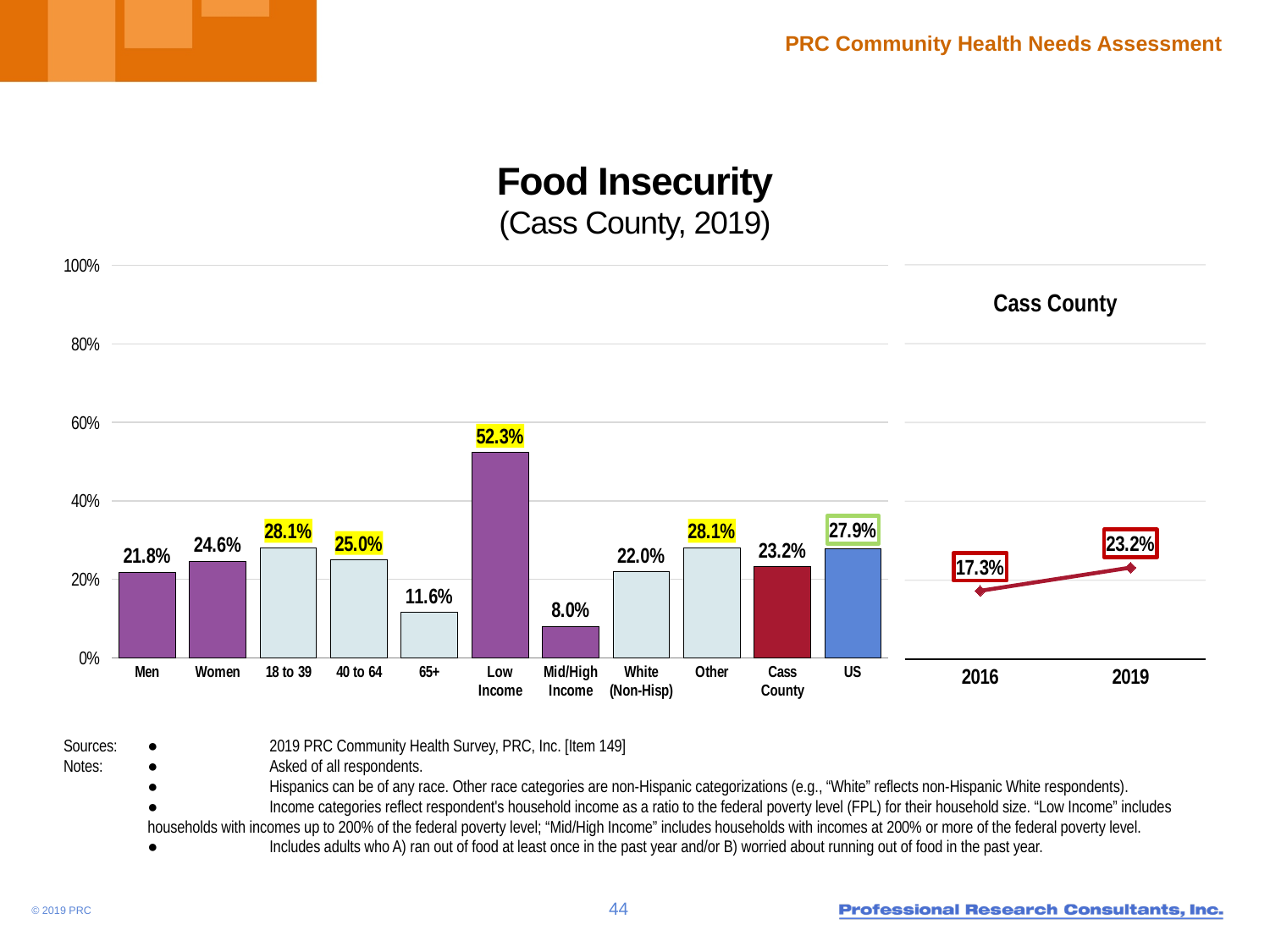
In the Food Insecurity bar chart, what is the value for Women? 24.6% In the Cass County trend chart on the right, what is the difference between the 2019 and 2016 values? 5.9% What kind of chart is the Food Insecurity chart on the left? bar chart In the Food Insecurity bar chart, what is the difference between the Low Income and Mid/High Income values? 44.3% In the Food Insecurity bar chart, which category has the highest value? Low Income How many categories are shown in the Food Insecurity bar chart? 11 In the Cass County trend chart on the right, does the value rise or fall from 2016 to 2019? rise In the Food Insecurity bar chart, what is the value for Low Income? 52.3% In the Cass County trend chart on the right, what is the value for 2016? 17.3% In the Food Insecurity bar chart, which is larger, the value for Cass County or the value for US? US In the Food Insecurity bar chart, which category has the lowest value? Mid/High Income In the Food Insecurity bar chart, is the value for 65+ greater or less than 20%? less